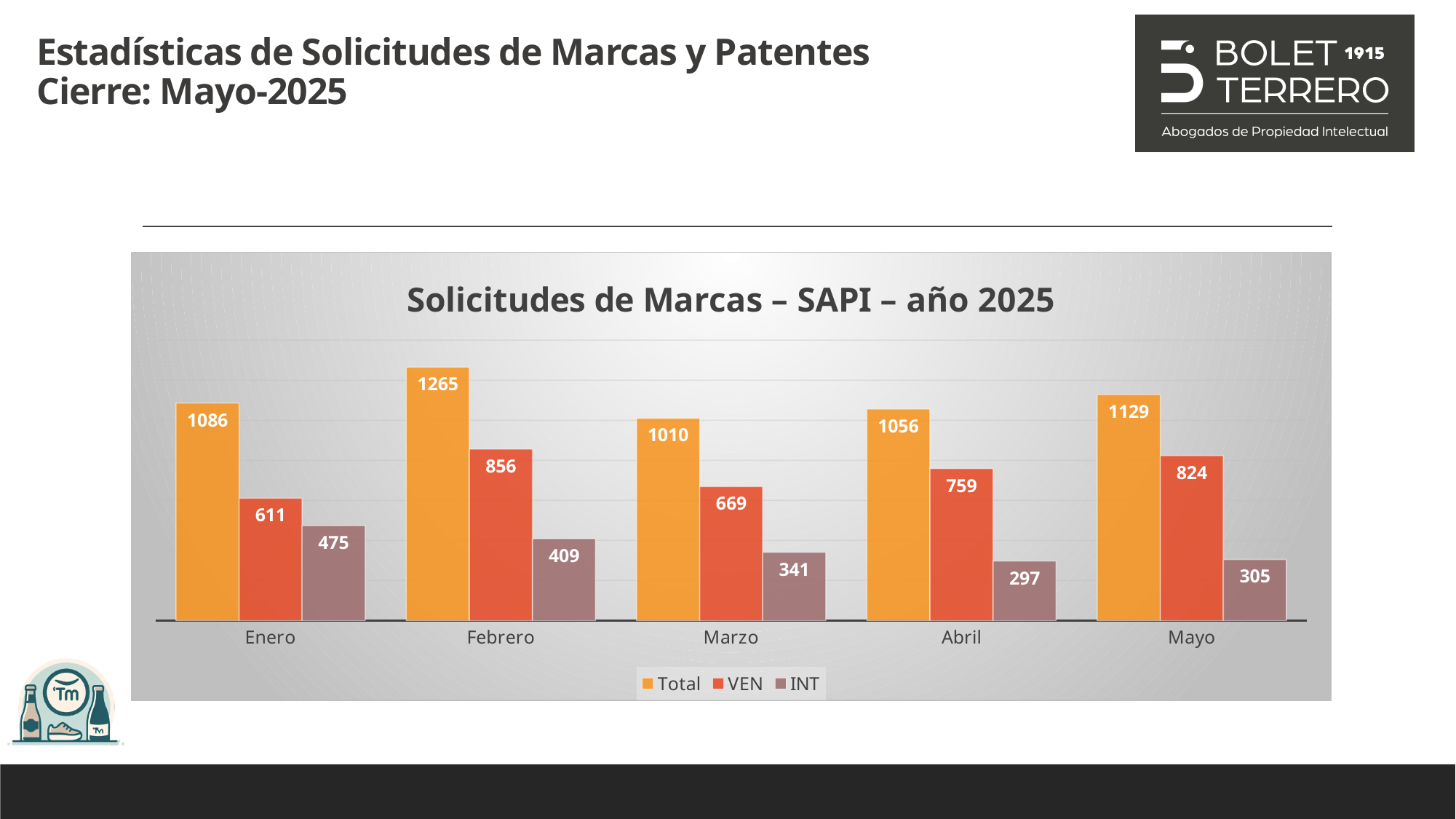
Which is larger, the Total for Mayo or the Total for Enero? Mayo Which month has the highest Total value? Febrero Does the INT series rise or fall from Enero to Abril? Fall How many months are shown on the x axis? 5 What is the title of the chart? Solicitudes de Marcas – SAPI – año 2025 What is the Total value for Febrero? 1265 What is the difference between the VEN values for Febrero and Enero? 245 What kind of chart is shown? Bar chart What is the VEN value for Abril? 759 What is the INT value for Mayo? 305 Which month has the lowest INT value? Abril How many series does the legend list? 3